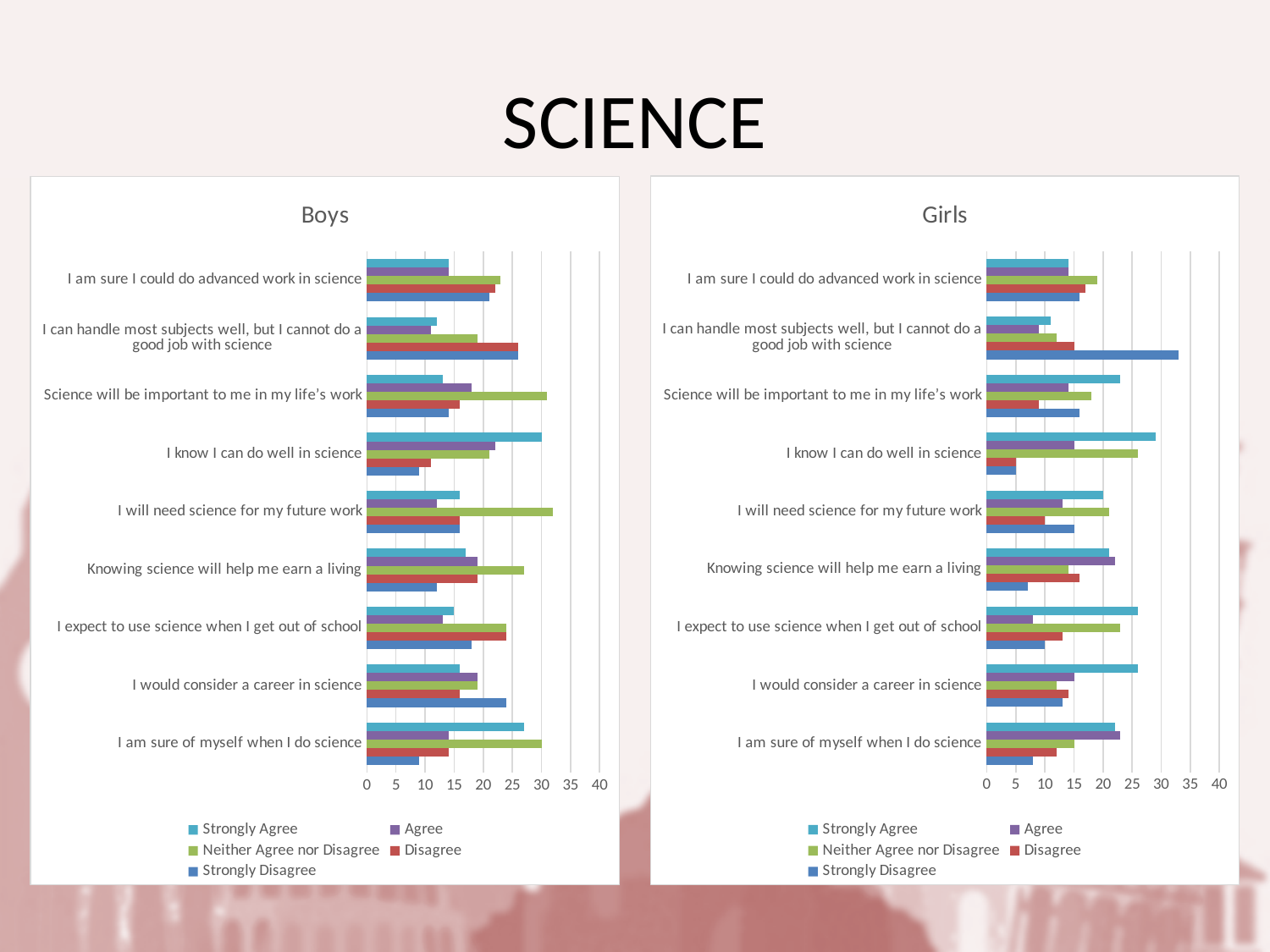
On the Boys chart, is the Strongly Agree value for "I know I can do well in science" greater or less than 25? greater How many series does the legend of the Girls chart list? 5 On the Boys chart, is the Disagree value for "I can handle most subjects well, but I cannot do a good job with science" greater or less than 20? greater How many statement categories are shown on the Boys chart? 9 On the Girls chart, which statement has the longest Strongly Disagree bar? I can handle most subjects well, but I cannot do a good job with science On the Girls chart, for "I can handle most subjects well, but I cannot do a good job with science", which is larger: Strongly Disagree or Agree? Strongly Disagree On the Girls chart, is the Strongly Disagree value for "I can handle most subjects well, but I cannot do a good job with science" greater or less than 30? greater What kind of chart is the Boys chart? Bar chart What are the titles of the two charts on the slide? Boys and Girls On the Boys chart, for "I know I can do well in science", which is larger: Strongly Agree or Strongly Disagree? Strongly Agree